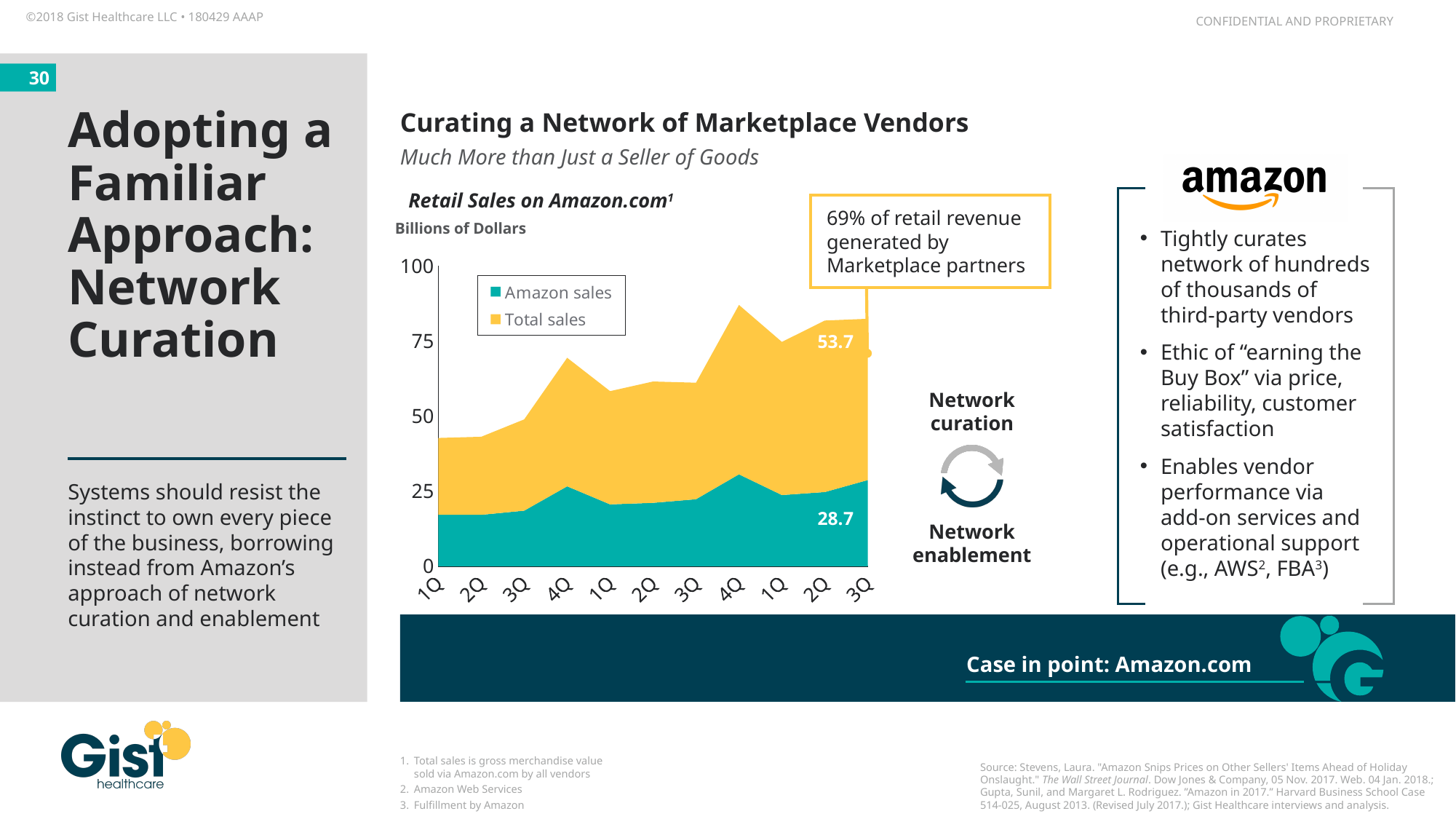
Do Amazon sales rise or fall overall from the first 1Q to the final 3Q? rise At the final 3Q, which labelled series is larger, Amazon sales or Total sales? Total sales Is the top of the stacked area at the first 1Q greater or less than 50? less What kind of chart is used to show Retail Sales on Amazon.com? Area chart Is the top of the stacked area at the second 4Q greater or less than 75? greater What unit is stated for the y axis of the Retail Sales on Amazon.com chart? Billions of Dollars What is the labelled value for Amazon sales at the final 3Q on the chart? 28.7 What is the difference between the two labelled values at the final 3Q (53.7 and 28.7)? 25.0 Is the Amazon sales value at the first 1Q greater or less than 25? less What is the labelled value for Total sales at the final 3Q on the chart? 53.7 How many series does the legend of the Retail Sales on Amazon.com chart list? 2 How many quarters are plotted along the x axis of the Retail Sales on Amazon.com chart? 11